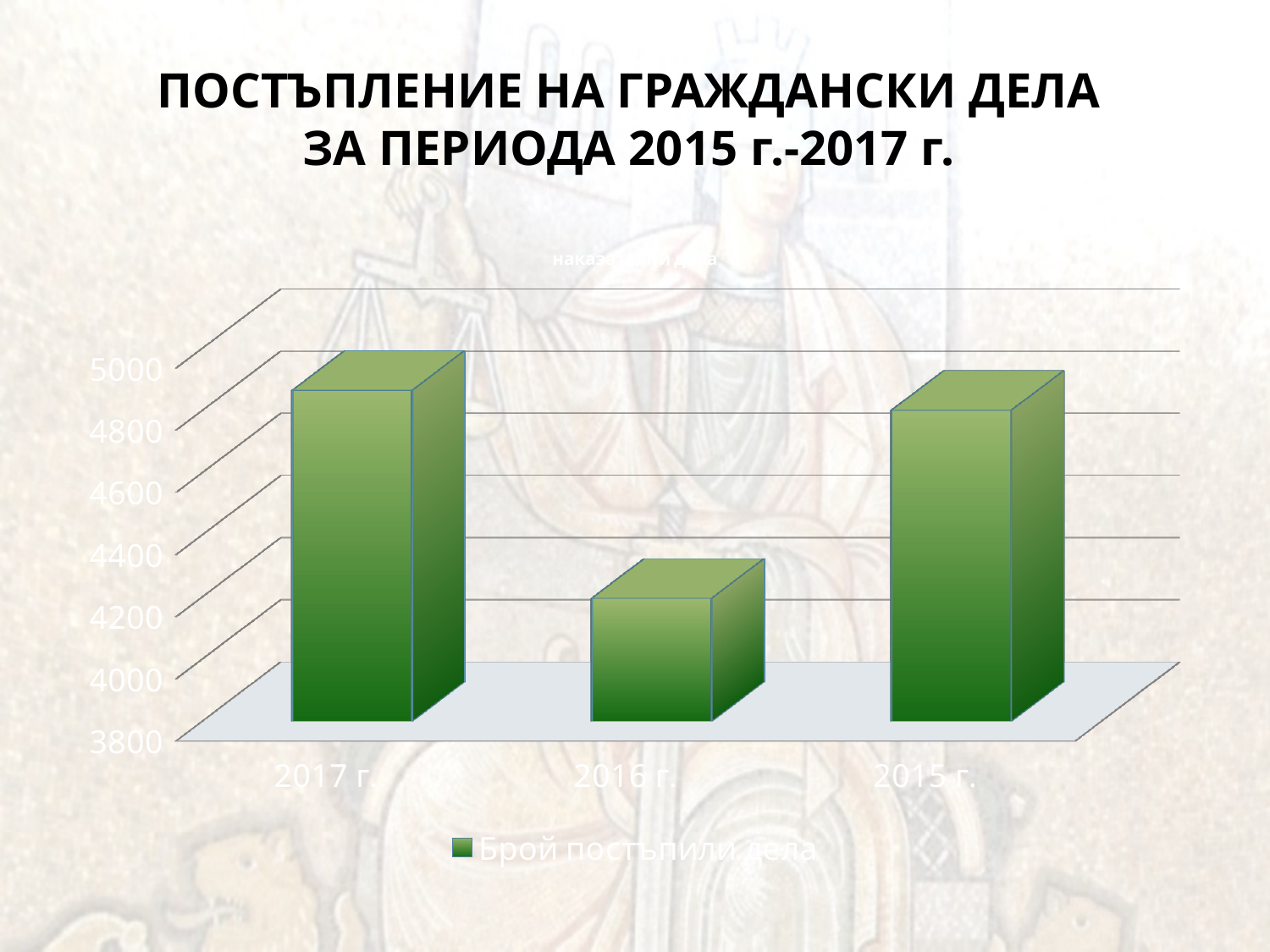
Is the value for 2016 г. greater or less than 4600? less What kind of chart is shown on the slide? bar chart Is the value for 2015 г. greater or less than 4600? greater Is the value for 2017 г. greater or less than 4600? greater What is the name of the series shown in the chart legend? Брой постъпили дела Which year has the highest number of received cases? 2017 г. How many categories are shown on the x axis of the chart? 3 How many series does the chart legend list? 1 What colour are the bars in the chart? green Which is larger, the value for 2016 г. or the value for 2015 г.? 2015 г. Which year has the lowest number of received cases? 2016 г. Which is larger, the value for 2017 г. or the value for 2015 г.? 2017 г.